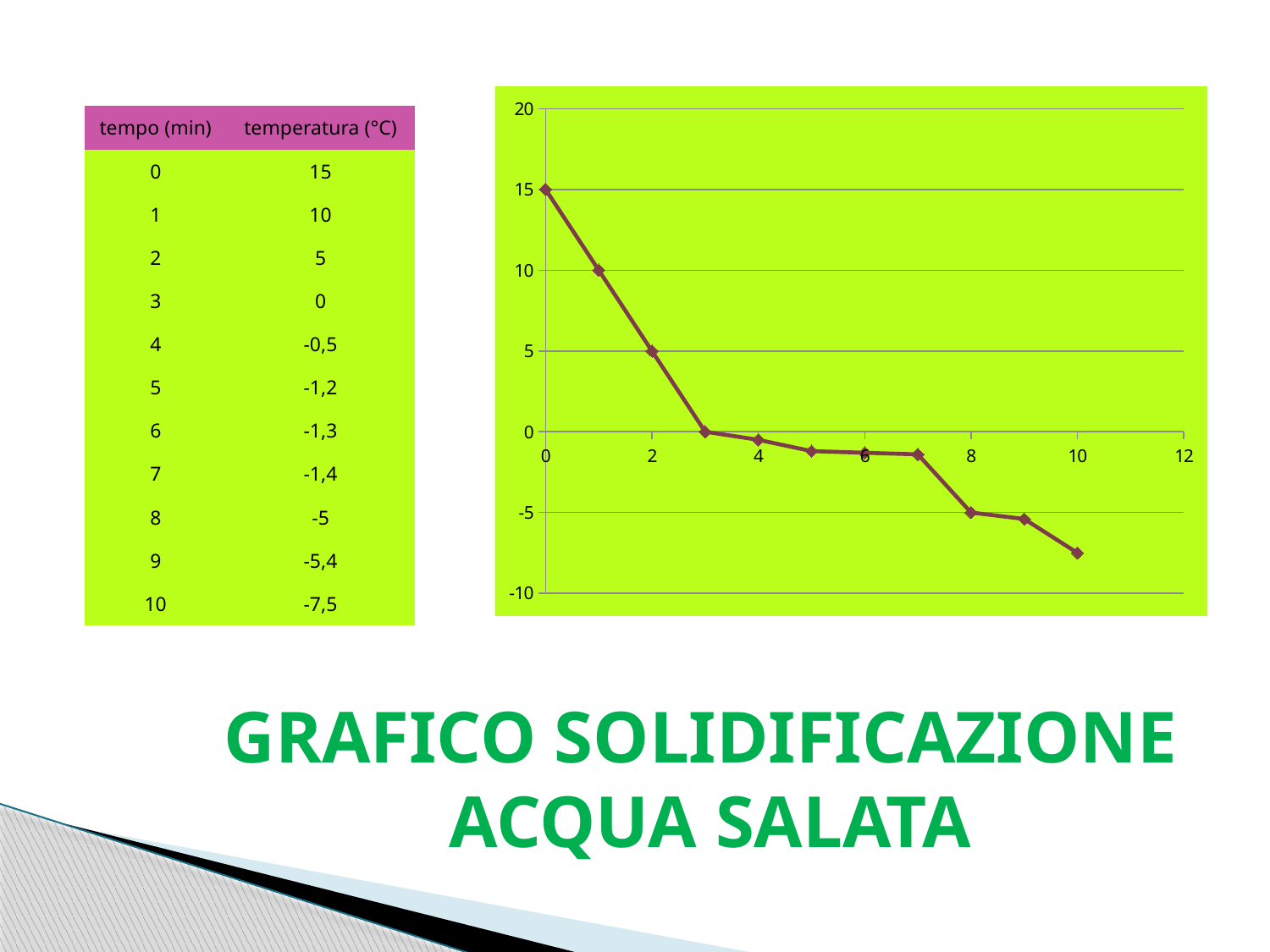
What is the temperature at time 6 min? -1,3 What kind of chart is shown on the slide? line chart Do the temperature values rise or fall as time increases along the x axis? fall What is the title shown on the slide for the chart? GRAFICO SOLIDIFICAZIONE ACQUA SALATA Which is larger, the temperature at 8 min or at 9 min? 8 min What is the temperature at time 10 min? -7,5 How many data points are plotted on the line chart? 11 What is the difference between the temperature at 0 min and at 2 min? 10 At which time is the temperature lowest? 10 What is the temperature at time 0 min? 15 What is the temperature at time 3 min? 0 At which time is the temperature highest? 0